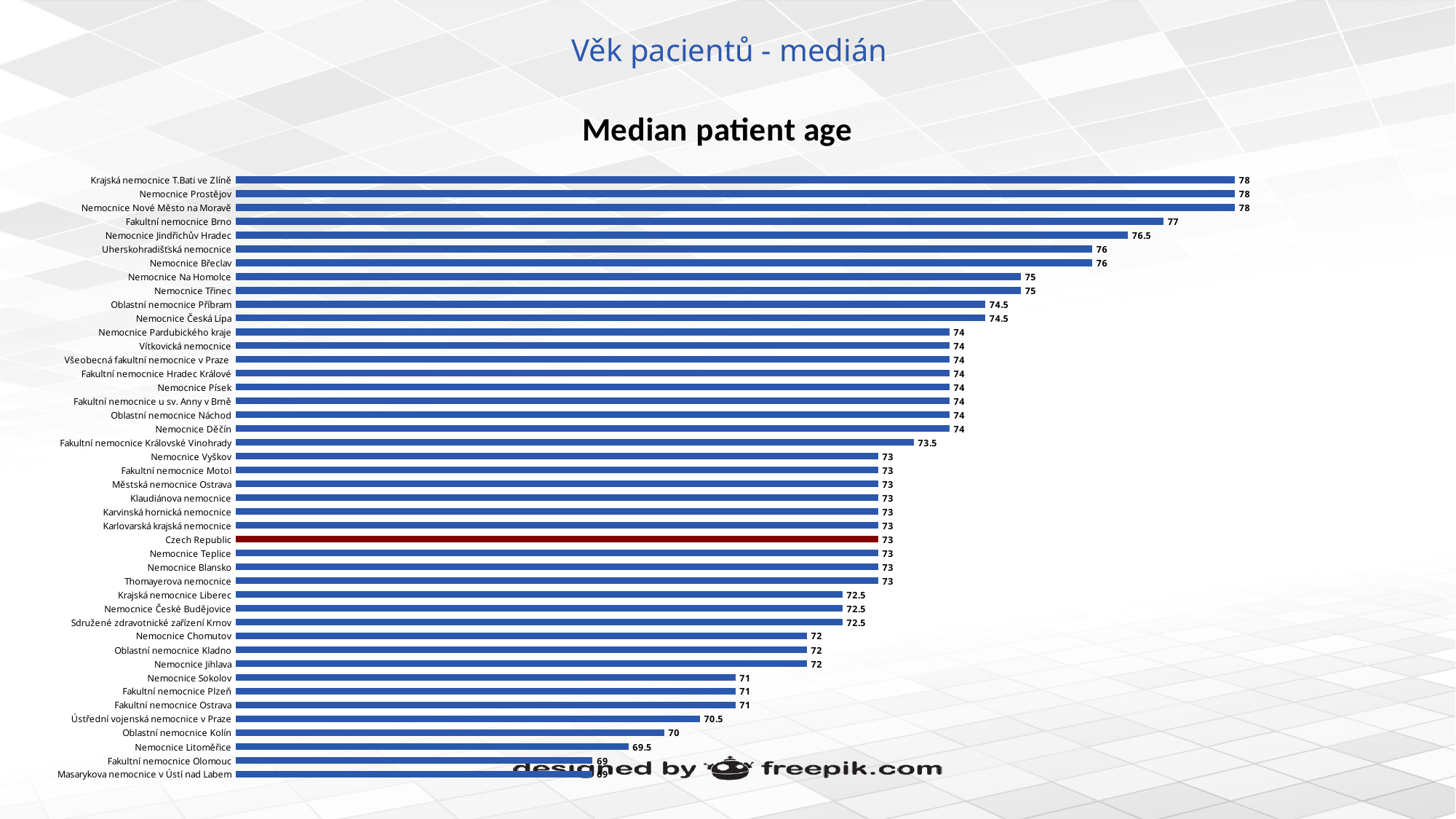
Which has a higher median patient age, Nemocnice Břeclav or Nemocnice Jihlava? Nemocnice Břeclav What is the median patient age for Oblastní nemocnice Kolín? 70 What is the highest median patient age shown on the chart? 78 What is the median patient age for Nemocnice Jindřichův Hradec? 76.5 What is the lowest median patient age shown on the chart? 69 What is the median patient age for Fakultní nemocnice Brno? 77 What type of chart is shown on the slide? Bar chart Which has a lower median patient age, Fakultní nemocnice Olomouc or Fakultní nemocnice Plzeň? Fakultní nemocnice Olomouc What is the median patient age shown for Czech Republic? 73 What is the difference between the median patient age for Nemocnice Na Homolce and Nemocnice Litoměřice? 5.5 What is the difference between the median patient age for Krajská nemocnice T.Bati ve Zlíně and Masarykova nemocnice v Ústí nad Labem? 9 Which bar on the chart is highlighted in a different colour (red) from the others? Czech Republic